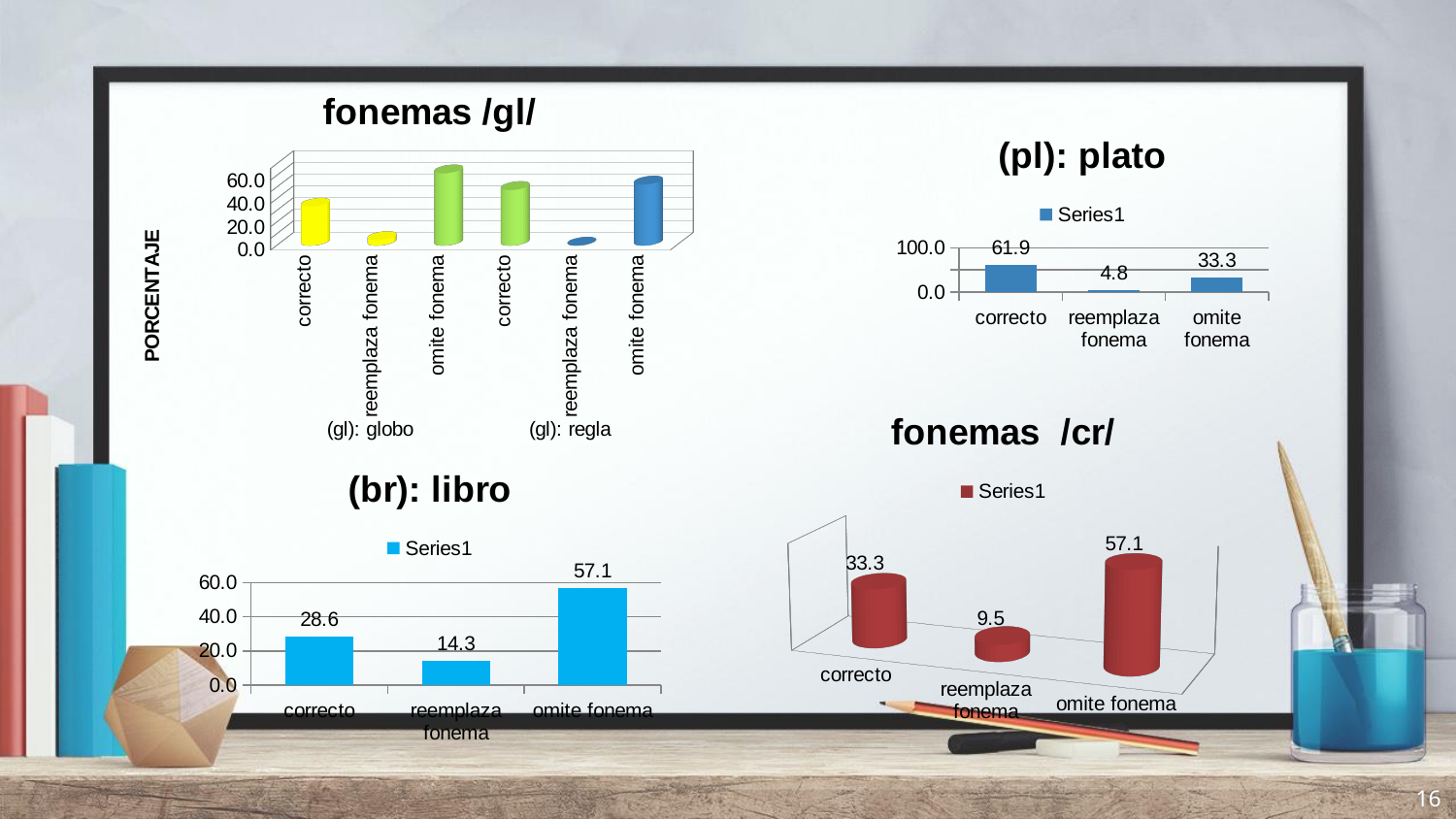
In the "fonemas /cr/" chart, what is the difference between the values for "omite fonema" and "correcto"? 23.8 In the "fonemas /gl/" chart, is the value for "correcto" in the "(gl): globo" group greater or less than 20.0? greater In the "(pl): plato" chart, which category has the lowest value? reemplaza fonema In the "(pl): plato" chart, what is the value for "correcto"? 61.9 In the "(br): libro" chart, which category has the highest value? omite fonema In the "(br): libro" chart, what is the difference between the values for "correcto" and "reemplaza fonema"? 14.3 In the "fonemas /cr/" chart, which is larger, the value for "correcto" or the value for "omite fonema"? omite fonema In the "fonemas /cr/" chart, what is the value for "reemplaza fonema"? 9.5 How many bars are plotted in the "fonemas /gl/" chart? 6 In the "fonemas /gl/" chart, is the value for "reemplaza fonema" in the "(gl): regla" group greater or less than 20.0? less In the "(br): libro" chart, what is the value for "omite fonema"? 57.1 What is the y-axis title of the "fonemas /gl/" chart? PORCENTAJE